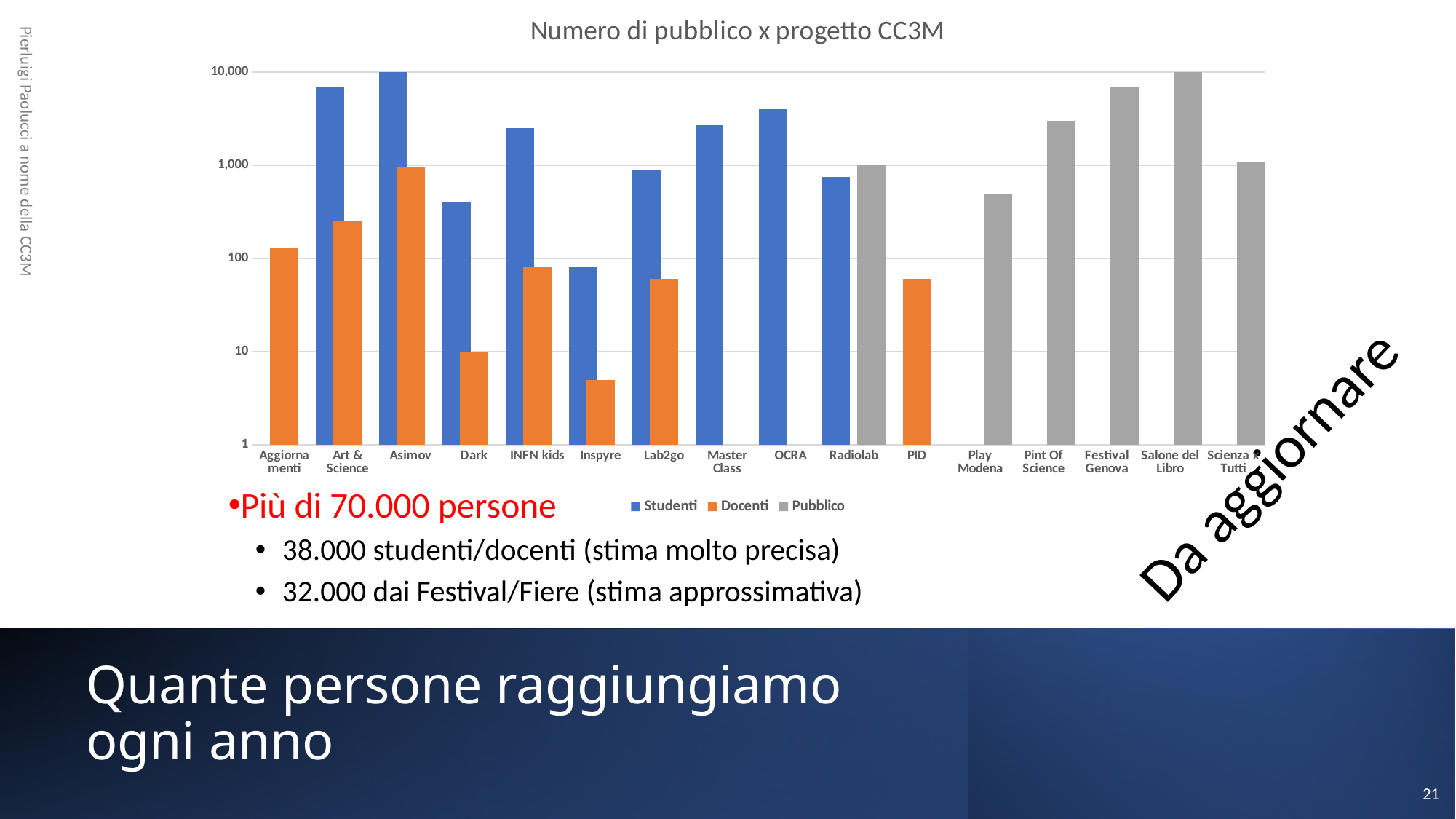
Which project has the highest Studenti value? Asimov How many series does the legend of the chart list? 3 What kind of chart is shown on the slide? Bar chart How many project categories are shown on the x axis of the chart? 16 Is the Studenti value for OCRA greater or less than 1,000? greater What is the Docenti value for Dark? 10 Is the Pubblico value for Play Modena greater or less than 1,000? less What is the title of the chart? Numero di pubblico x progetto CC3M Which project has the lowest Docenti value? Inspyre Which has the larger Studenti value, Master Class or Lab2go? Master Class